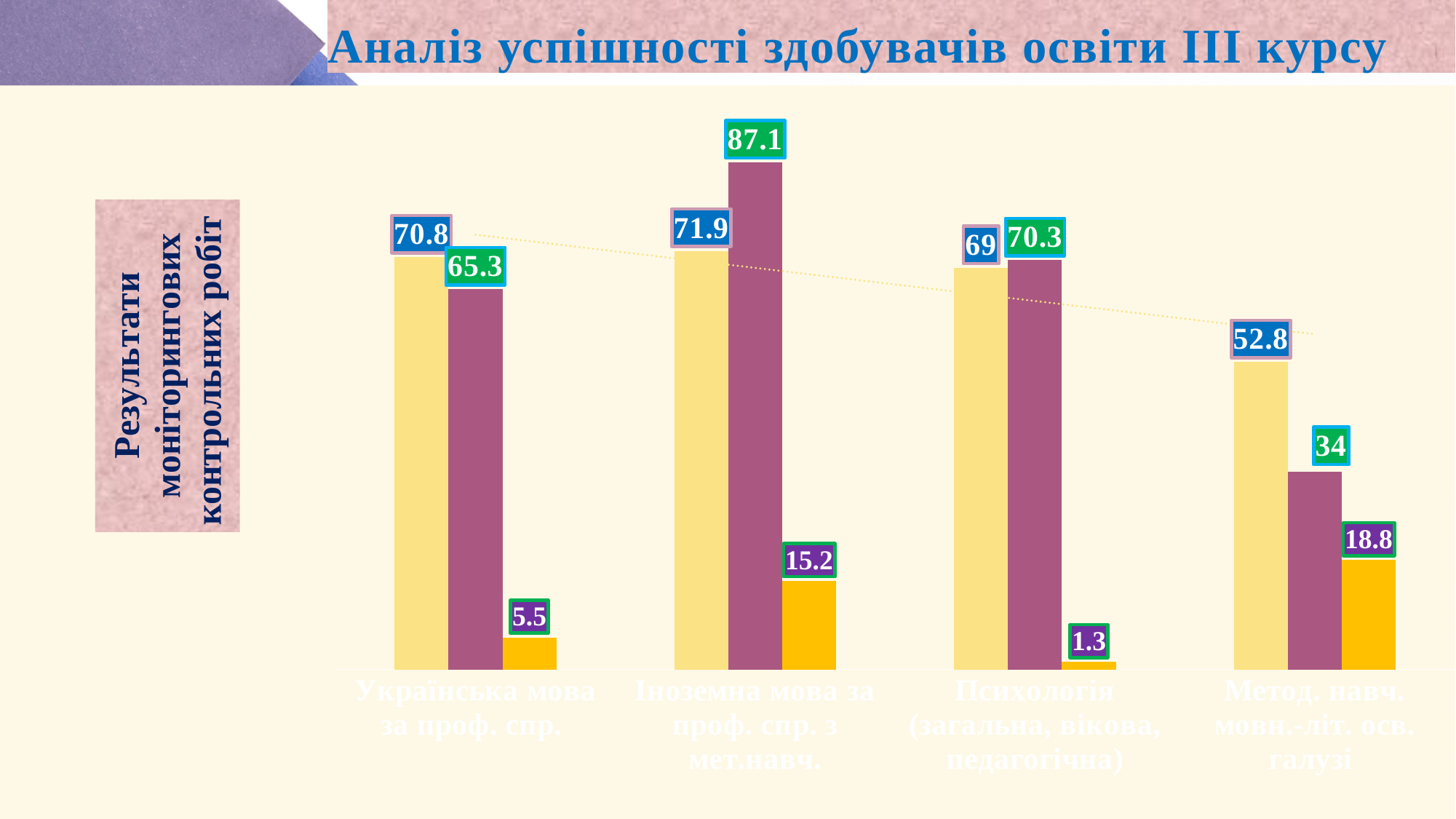
What is the title of the slide containing the chart? Аналіз успішності здобувачів освіти ІІІ курсу What is the value of the yellow bar for "Українська мова за проф. спр."? 70.8 What is the value of the purple bar for "Іноземна мова за проф. спр. з мет.навч."? 87.1 What is the value of the purple bar for "Метод. навч. мовн.-літ. осв. галузі"? 34 Which category has the highest purple bar? Іноземна мова за проф. спр. з мет.навч. What type of chart is shown on the slide? bar chart What is the value of the orange bar for "Психологія (загальна, вікова, педагогічна)"? 1.3 How many categories are shown along the x axis of the chart? 4 Which is larger for "Українська мова за проф. спр.": the yellow bar or the purple bar? the yellow bar What is the difference between the purple bar and the yellow bar for "Іноземна мова за проф. спр. з мет.навч."? 15.2 Which category has the highest orange bar? Метод. навч. мовн.-літ. осв. галузі Which category has the lowest yellow bar? Метод. навч. мовн.-літ. осв. галузі